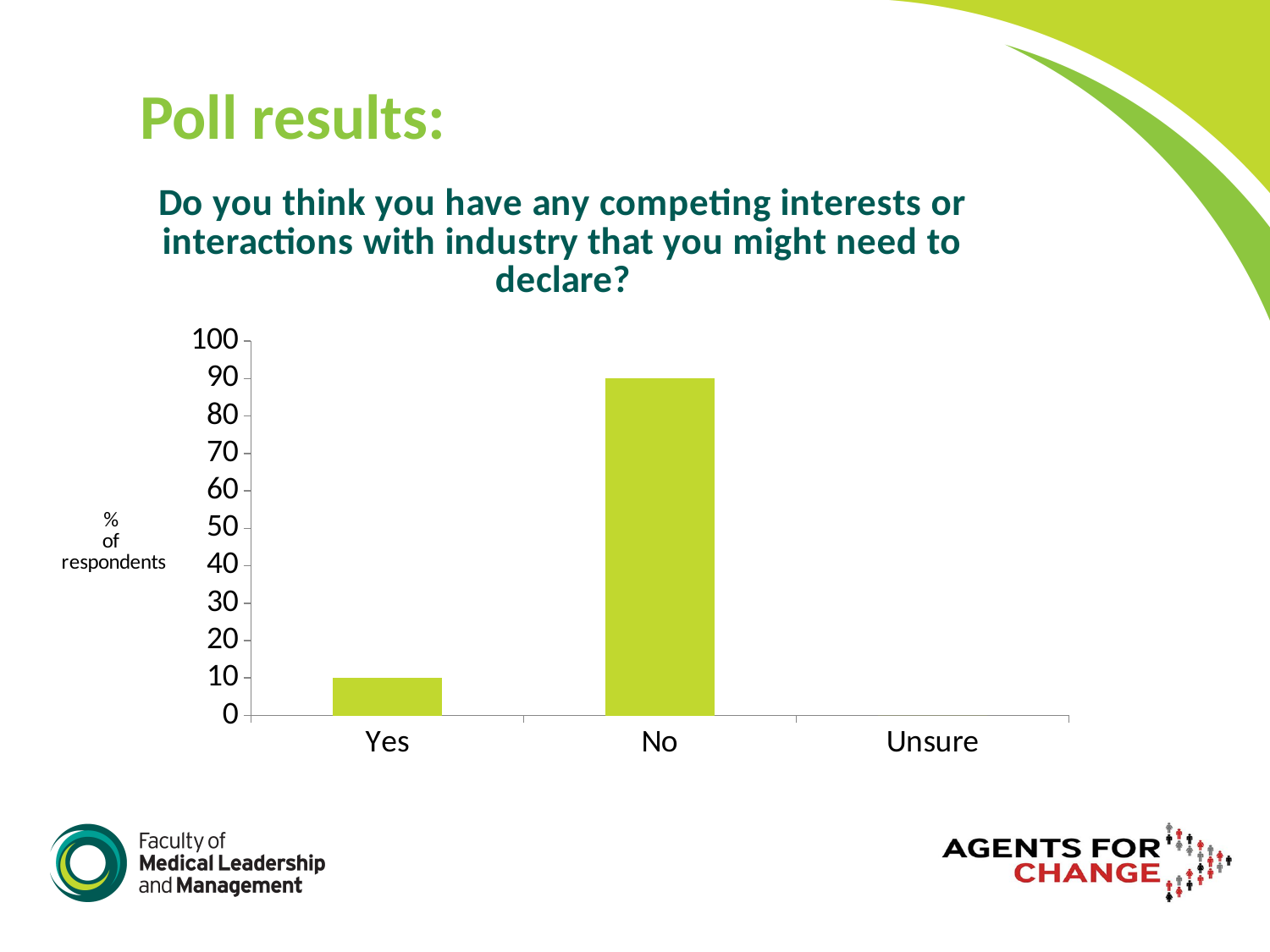
Which is larger, the value for Yes or the value for No? No What question does the poll chart report results for? Do you think you have any competing interests or interactions with industry that you might need to declare? What is the label on the vertical axis of the chart? % of respondents How many categories are shown on the x axis of the chart? 3 Which category has the highest value in the chart? No What is the value for Yes in the chart? 10 What is the difference between the values for No and Yes? 80 What is the value for No in the chart? 90 Which category has the lowest value in the chart? Unsure Is the value for Yes greater or less than 20? less Is the value for No greater or less than 50? greater What kind of chart is shown on the slide? bar chart